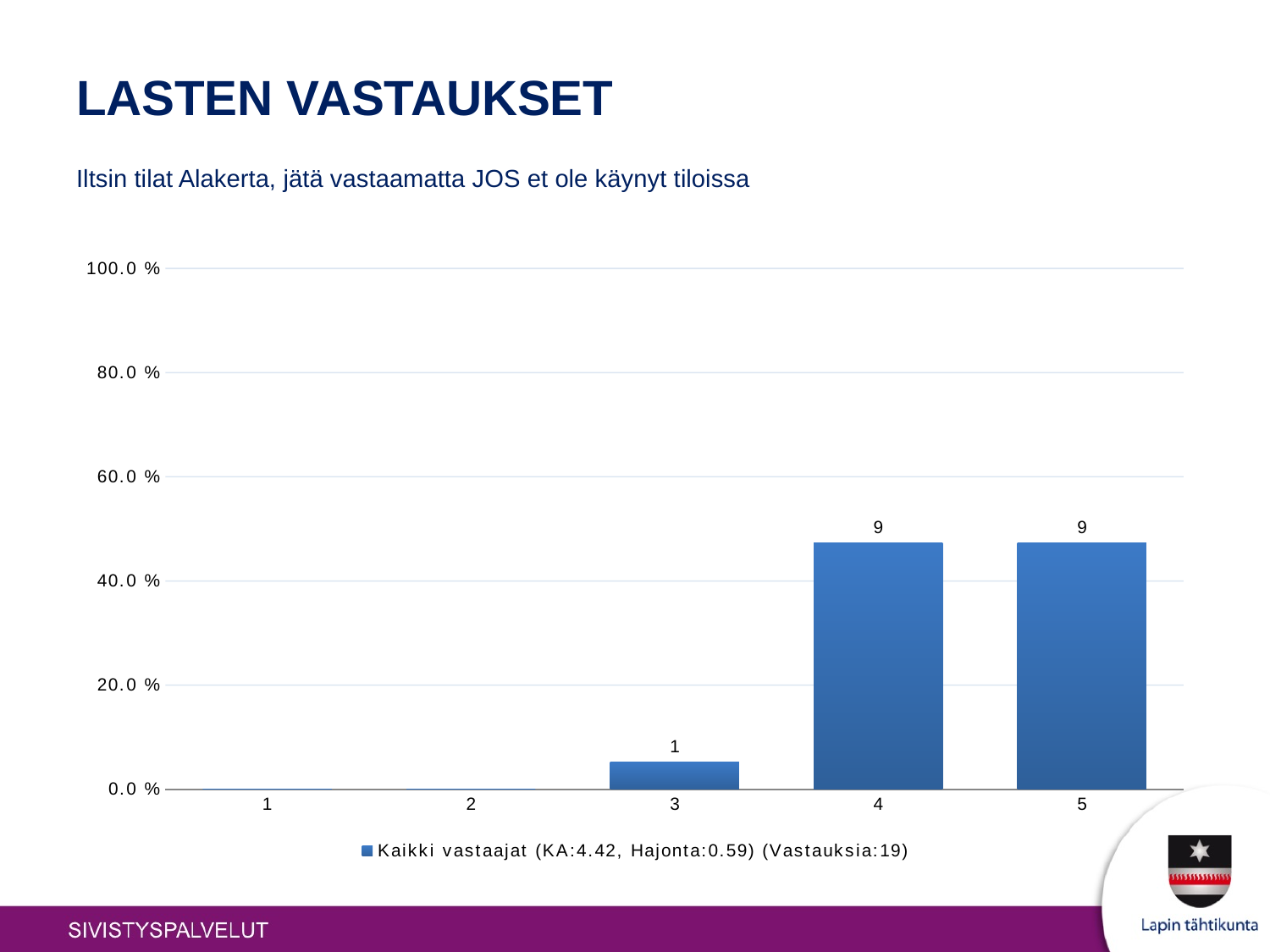
What is the difference between the data labels for category 5 and category 3? 8 Is the value for category 4 greater or less than 40.0 %? greater Do categories 4 and 5 have the same data label value? Yes What kind of chart is shown on the slide? Bar chart How many series does the legend list? 1 What is the data label on the bar for category 3? 1 Which has the larger value, category 3 or category 4? 4 What is the data label on the bar for category 4? 9 What is the data label on the bar for category 5? 9 How many categories are shown on the x axis? 5 Is the value for category 3 greater or less than 20.0 %? less According to the legend, how many responses (Vastauksia) does the series include? 19